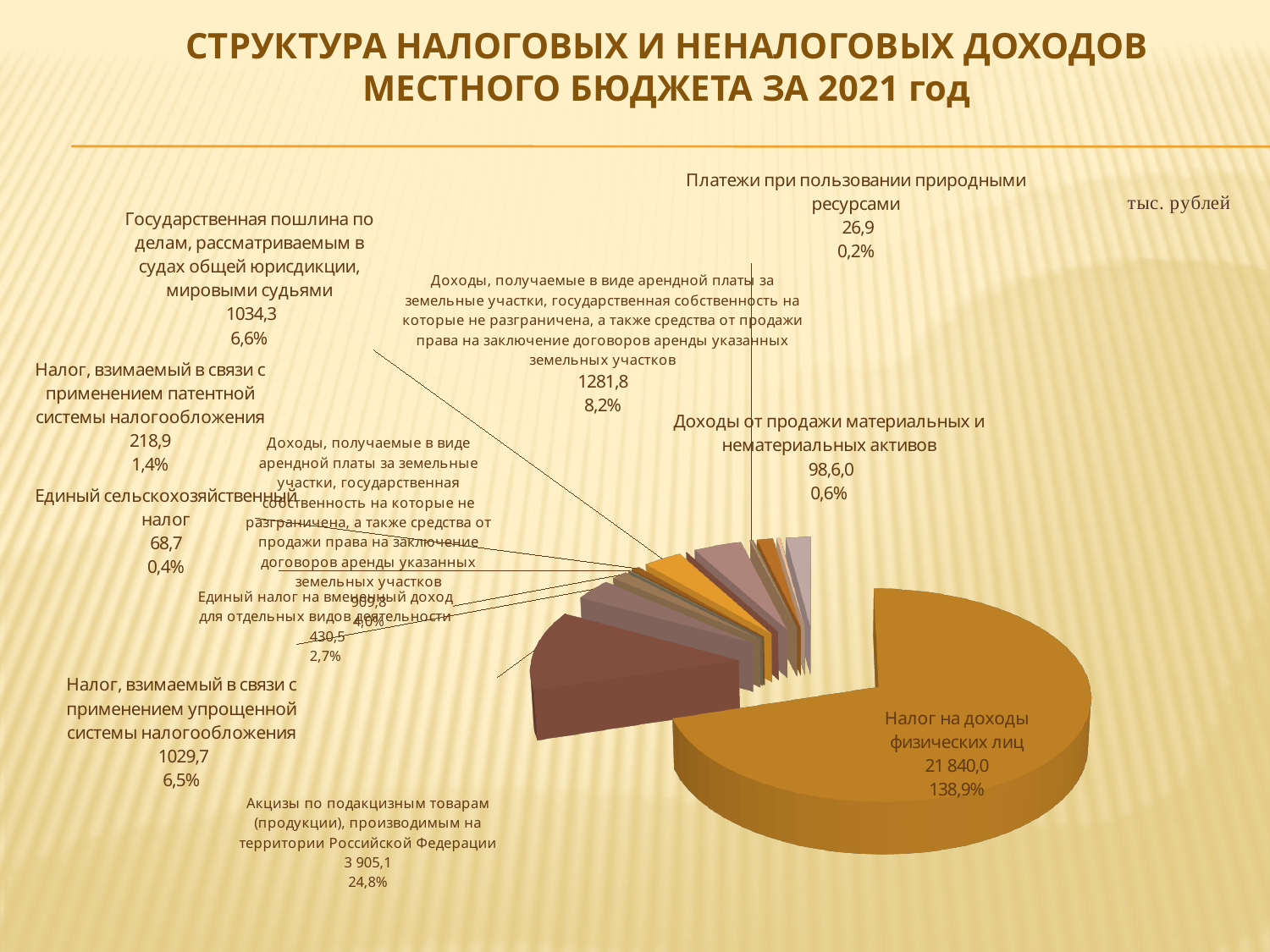
What share of the pie does Акцизы по подакцизным товарам (продукции), производимым на территории Российской Федерации have? 24,8% Which is larger: Налог, взимаемый в связи с применением патентной системы налогообложения or Единый налог на вмененный доход для отдельных видов деятельности? Единый налог на вмененный доход для отдельных видов деятельности In what units are the chart values given, according to the note on the slide? тыс. рублей Which category has the smallest value shown on the chart? Платежи при пользовании природными ресурсами What kind of chart is shown on the slide? pie chart Which category has the largest slice of the pie? Налог на доходы физических лиц What share of the pie does Государственная пошлина по делам, рассматриваемым в судах общей юрисдикции, мировыми судьями have? 6,6% What is the value for Единый сельскохозяйственный налог? 68,7 What is the value for Налог на доходы физических лиц? 21 840,0 What is the difference between the values for Государственная пошлина по делам, рассматриваемым в судах общей юрисдикции, мировыми судьями (1034,3) and Налог, взимаемый в связи с применением упрощенной системы налогообложения (1029,7)? 4,6 What is the value for Налог, взимаемый в связи с применением упрощенной системы налогообложения? 1029,7 What is the difference between the values for Налог, взимаемый в связи с применением патентной системы налогообложения (218,9) and Единый сельскохозяйственный налог (68,7)? 150,2